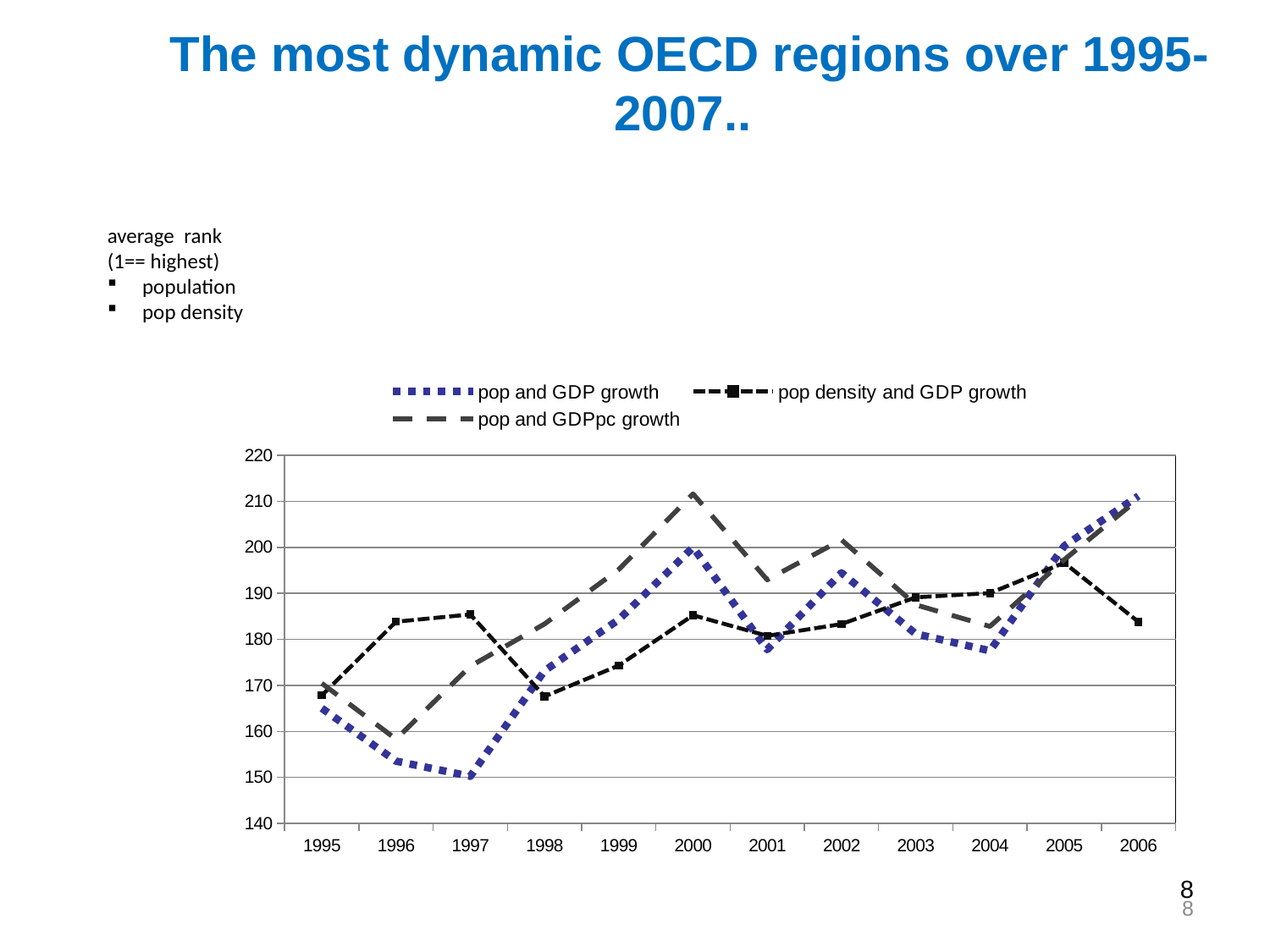
Is the value for pop and GDP growth in 1997 greater or less than 160? less Is the value for pop and GDP growth in 2006 greater or less than 200? greater In 1996, which series has the larger value: pop density and GDP growth or pop and GDP growth? pop density and GDP growth How many years are plotted along the x axis of the chart? 12 How many series does the chart's legend list? 3 In 2000, which series has the larger value: pop and GDPpc growth or pop density and GDP growth? pop and GDPpc growth Does the pop and GDP growth series rise or fall between 1997 and 2000? rise What kind of chart is shown on the slide? line chart In which year does the pop and GDP growth series reach its lowest value? 1997 In which year does the pop density and GDP growth series reach its highest value? 2005 Is the value for pop density and GDP growth in 2006 greater or less than 190? less